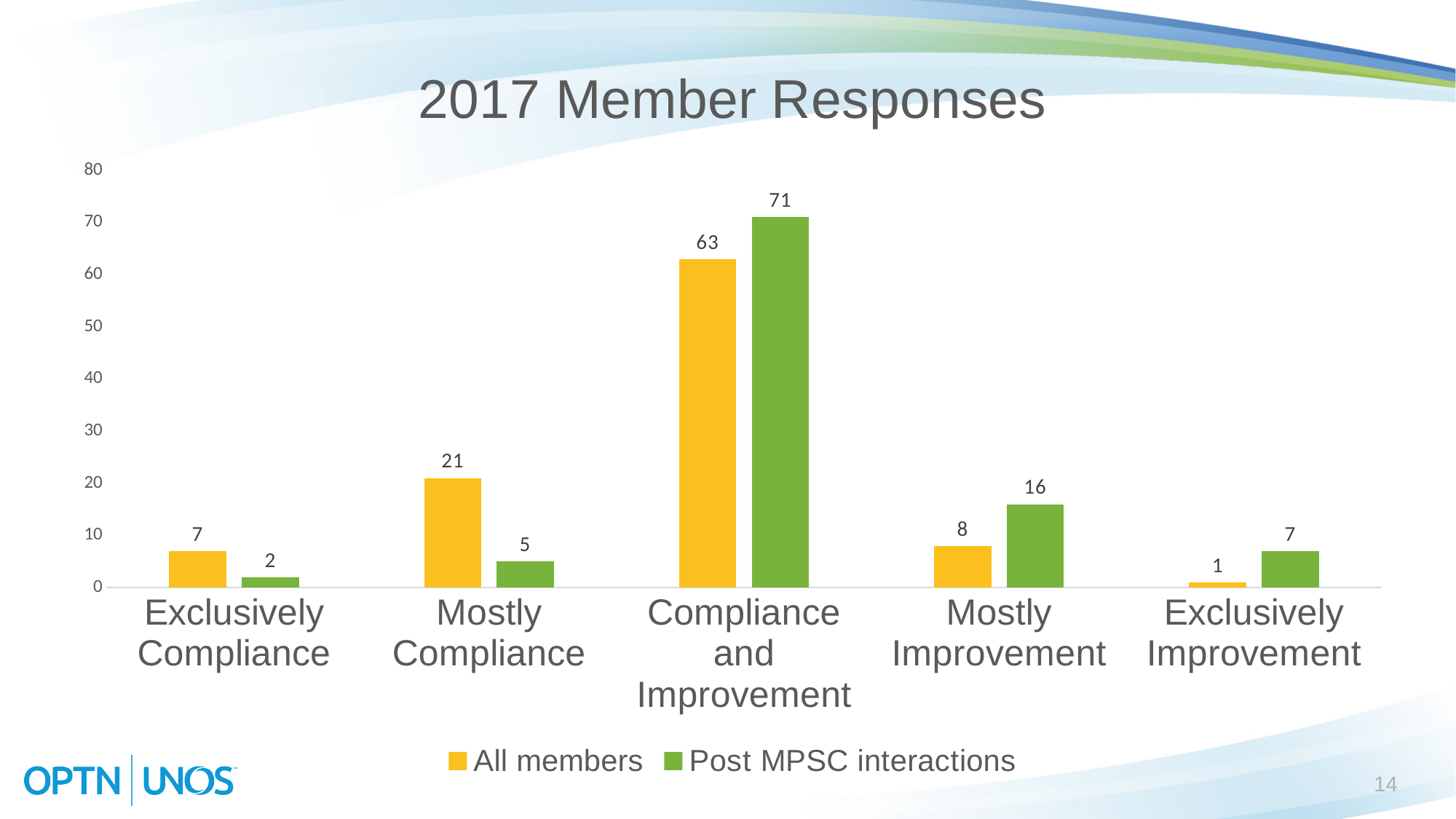
What kind of chart is shown on the slide? Bar chart What is the difference between the All members and Post MPSC interactions values in the Mostly Compliance category? 16 What is the value for All members in the Exclusively Improvement category? 1 What is the difference between the Post MPSC interactions and All members values in the Compliance and Improvement category? 8 What is the value for Post MPSC interactions in the Mostly Improvement category? 16 How many series does the legend list? 2 Which is larger in the Exclusively Compliance category: All members or Post MPSC interactions? All members What is the title of the chart? 2017 Member Responses Which category has the highest value for Post MPSC interactions? Compliance and Improvement How many categories are shown on the x axis? 5 What is the value for All members in the Compliance and Improvement category? 63 Which category has the lowest value for All members? Exclusively Improvement